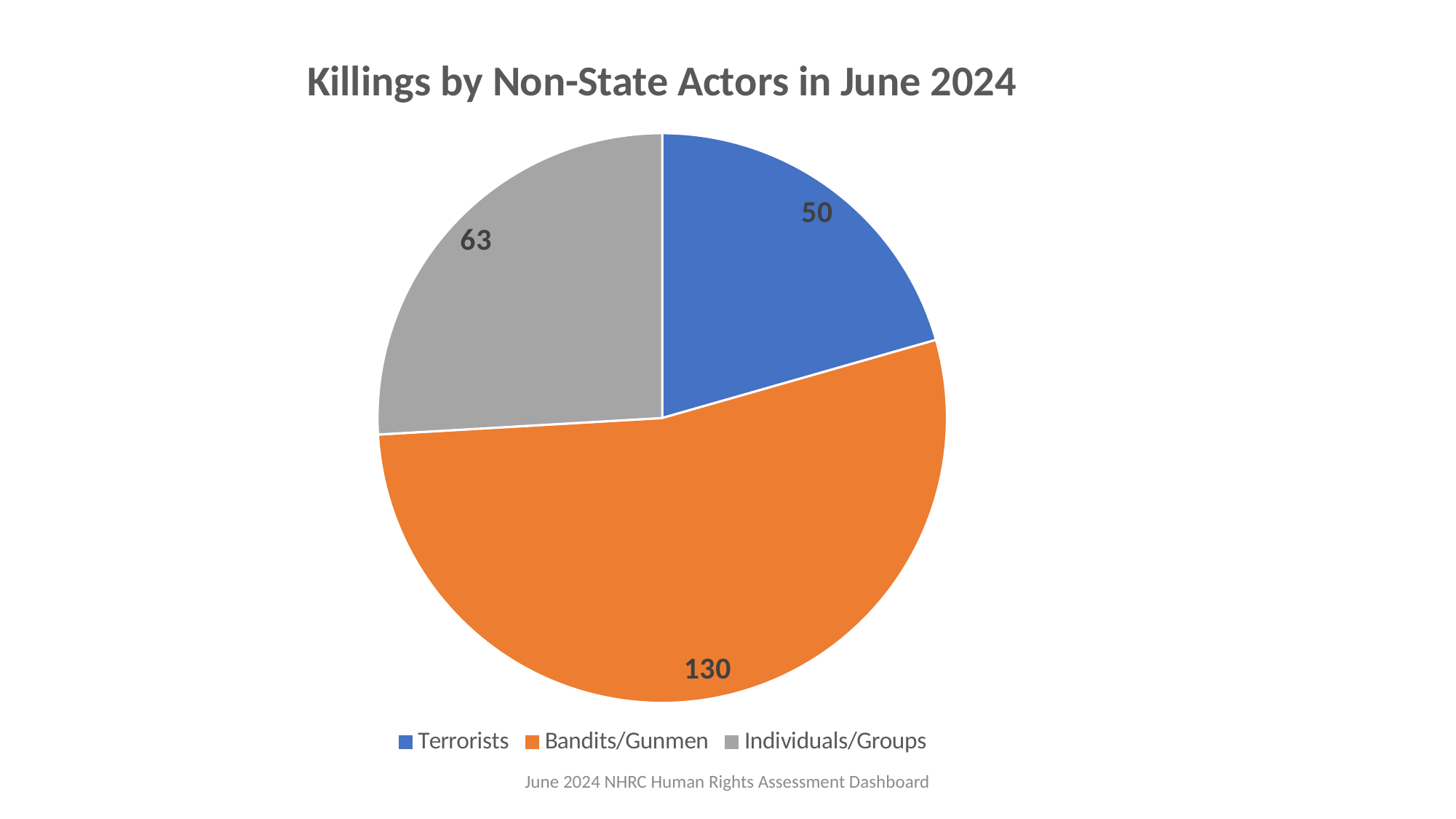
What is the difference between the killings by Individuals/Groups and by Terrorists? 13 Which is larger, the value for Individuals/Groups or the value for Terrorists? Individuals/Groups How many categories does the pie chart show? 3 What share of the total killings is attributed to Bandits/Gunmen? 53.5% Which category accounts for the most killings? Bandits/Gunmen What is the difference between the killings by Bandits/Gunmen and by Individuals/Groups? 67 How many killings are attributed to Bandits/Gunmen? 130 How many killings are attributed to Individuals/Groups? 63 Which category accounts for the fewest killings? Terrorists How many killings are attributed to Terrorists? 50 What type of chart is shown on the slide? Pie chart What is the title of the chart? Killings by Non-State Actors in June 2024